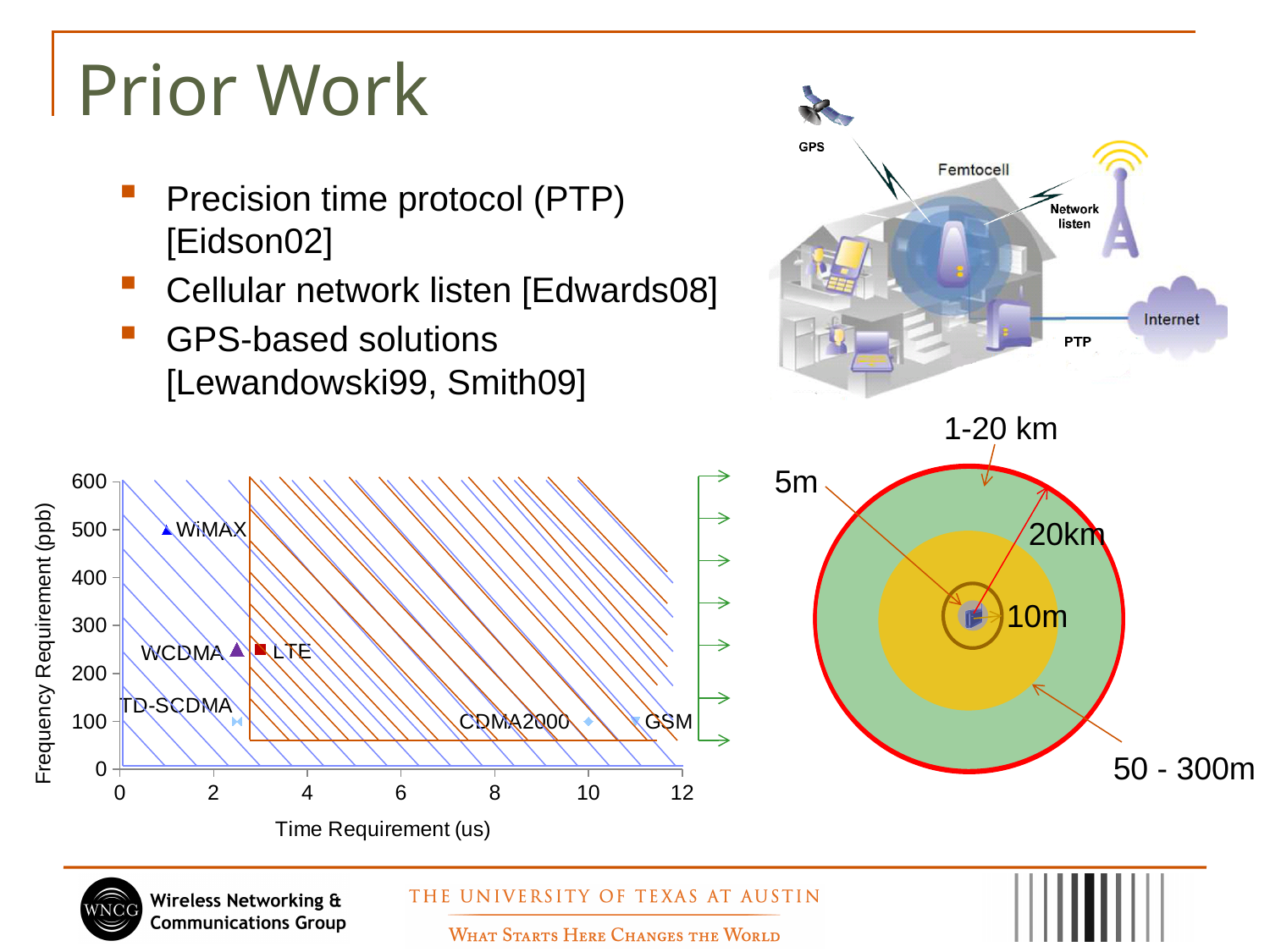
Which technology has the lowest time requirement in the scatter chart? WiMAX How many labeled data points are plotted in the scatter chart? 6 Which has a larger time requirement, GSM or WiMAX? GSM What kind of chart is shown at the bottom left of the slide? scatter chart What is the title of the x axis of the scatter chart? Time Requirement (us) Is the time requirement for GSM greater or less than 10 us? greater Is the frequency requirement for WiMAX greater or less than 400 ppb? greater Is the frequency requirement for TD-SCDMA greater or less than 200 ppb? less Which has a larger frequency requirement, WiMAX or LTE? WiMAX Which technology has the highest frequency requirement in the scatter chart? WiMAX What is the title of the y axis of the scatter chart? Frequency Requirement (ppb)